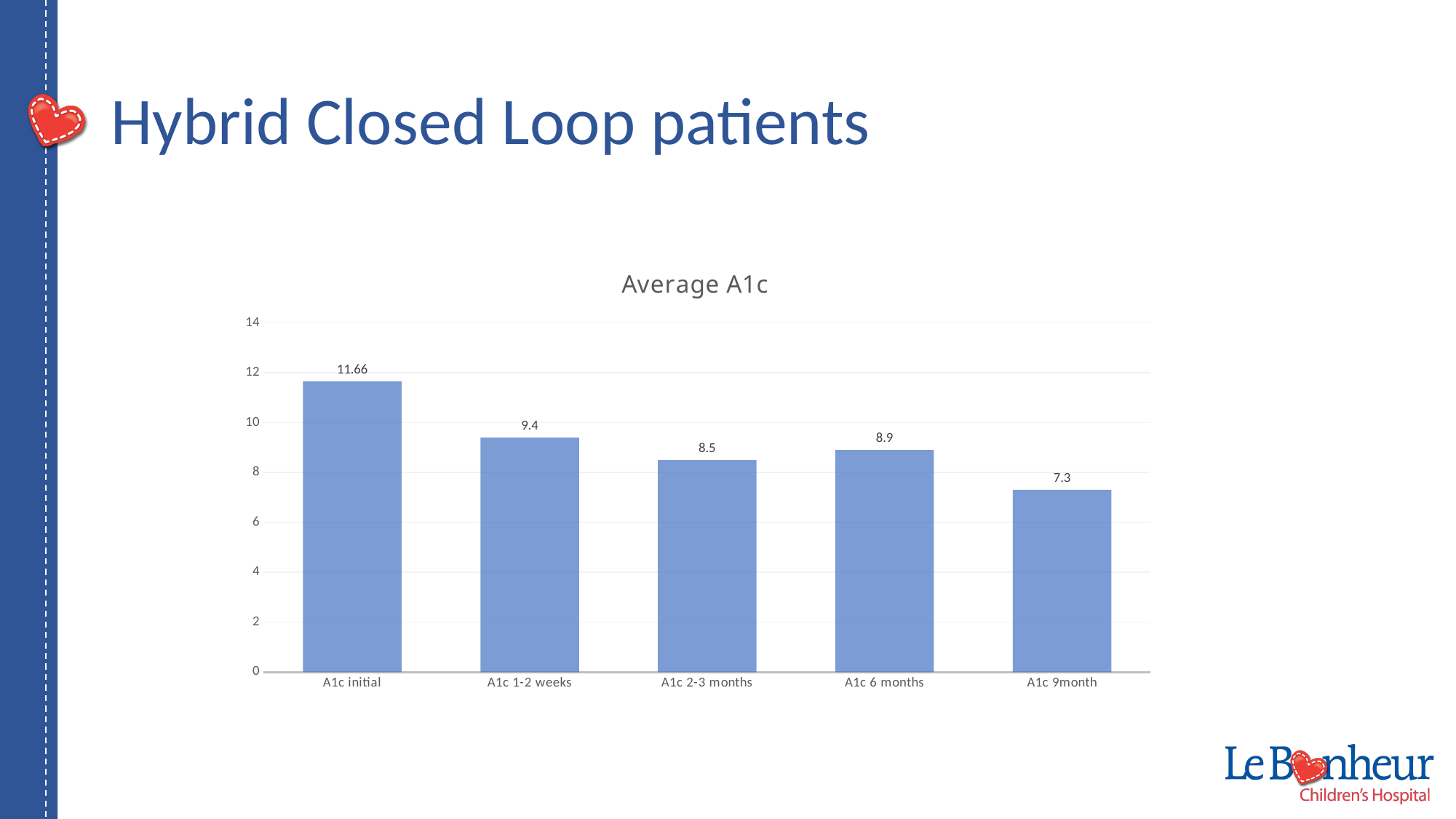
What is the average A1c value for A1c initial? 11.66 What is the average A1c value for A1c 9month? 7.3 Is the value for A1c 9month greater or less than 8? less Which category has the lowest average A1c? A1c 9month What is the difference between the A1c initial value and the A1c 9month value? 4.36 Which category has the highest average A1c? A1c initial What is the difference between the A1c 6 months value and the A1c 2-3 months value? 0.4 Which is larger, the value for A1c 1-2 weeks or the value for A1c 6 months? A1c 1-2 weeks What is the title of the chart? Average A1c How many categories are shown on the chart? 5 What is the average A1c value for A1c 2-3 months? 8.5 What kind of chart is shown on the slide? bar chart